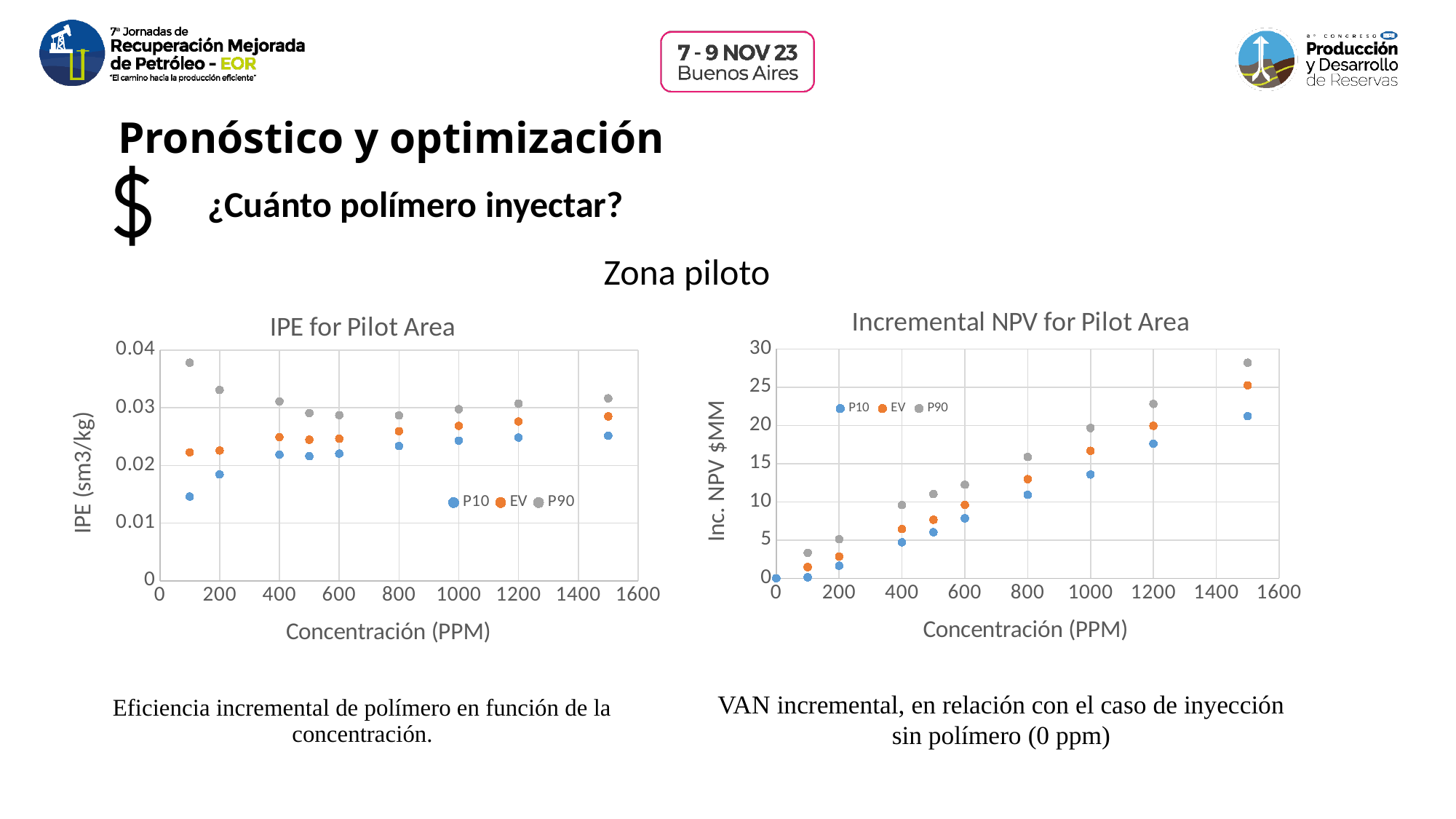
What is the y-axis label of the 'Incremental NPV for Pilot Area' chart? Inc. NPV $MM In the 'IPE for Pilot Area' chart, which series has the highest value at 100 PPM? P90 What kind of chart is the 'IPE for Pilot Area' chart? scatter chart In the 'Incremental NPV for Pilot Area' chart, is the P10 value at 1000 PPM greater or less than 15? less In the 'IPE for Pilot Area' chart, is the P10 value at 100 PPM greater or less than 0.02? less In the 'Incremental NPV for Pilot Area' chart, do the values rise or fall as concentration increases? rise What is the x-axis label of the 'IPE for Pilot Area' chart? Concentración (PPM) How many series does the legend of the 'Incremental NPV for Pilot Area' chart list? 3 In the 'Incremental NPV for Pilot Area' chart, which is larger at 800 PPM, the P90 value or the EV value? P90 In the 'Incremental NPV for Pilot Area' chart, which series has the lowest value at 1500 PPM? P10 In the 'IPE for Pilot Area' chart, is the P90 value at 100 PPM greater or less than 0.03? greater